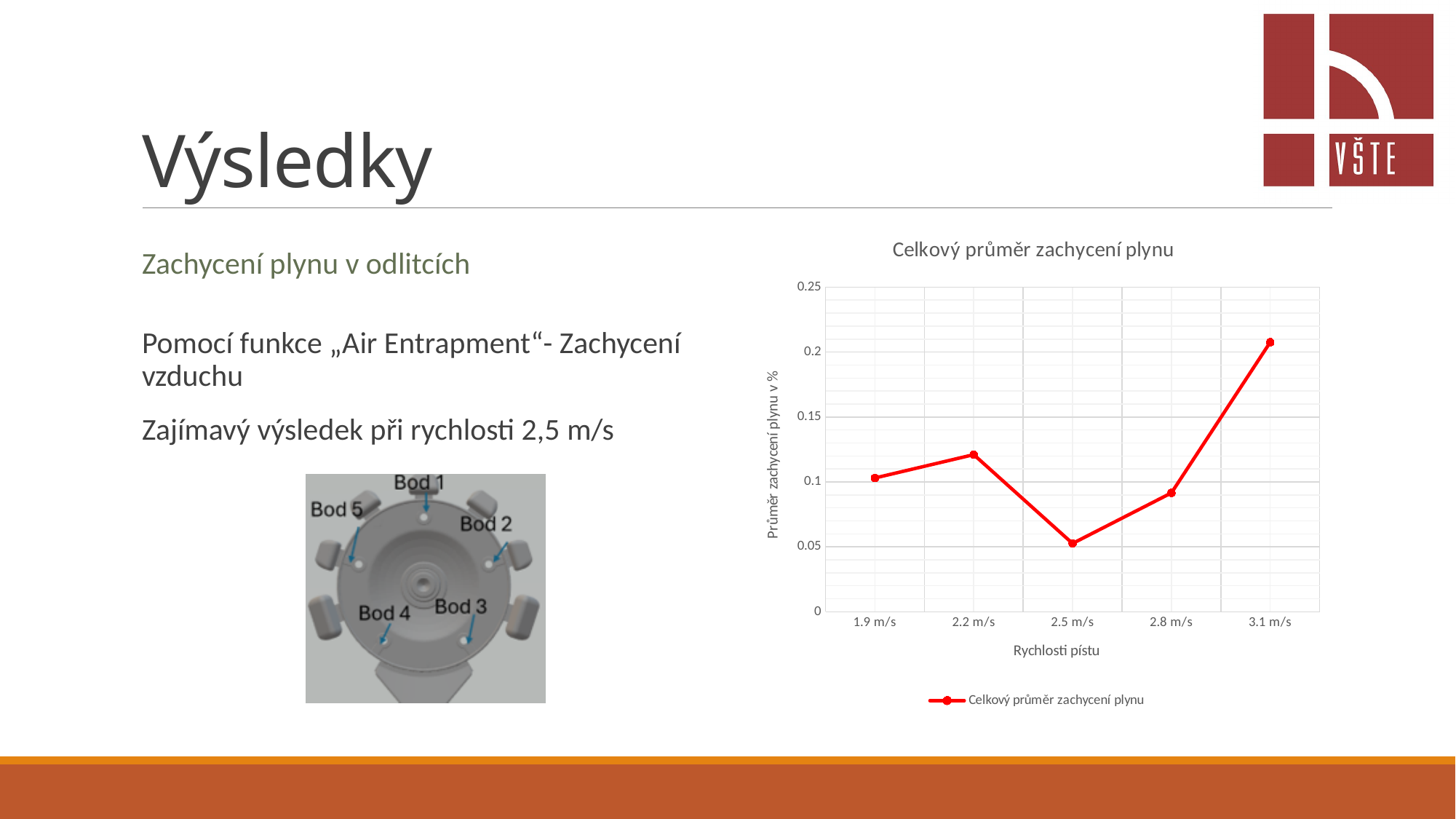
At which piston speed is the average gas entrapment lowest? 2.5 m/s At which piston speed is the average gas entrapment highest? 3.1 m/s Do the values rise or fall from 2.5 m/s to 3.1 m/s? rise What is the label of the x axis? Rychlosti pístu Is the value for 2.2 m/s greater or less than 0.1? greater How many piston speed categories are plotted on the x axis? 5 How many series does the legend list? 1 What is the title of the chart? Celkový průměr zachycení plynu Is the value for 2.5 m/s greater or less than 0.1? less Which has the larger value, 2.2 m/s or 2.8 m/s? 2.2 m/s What kind of chart is shown on the slide? line chart Is the value for 3.1 m/s greater or less than 0.2? greater